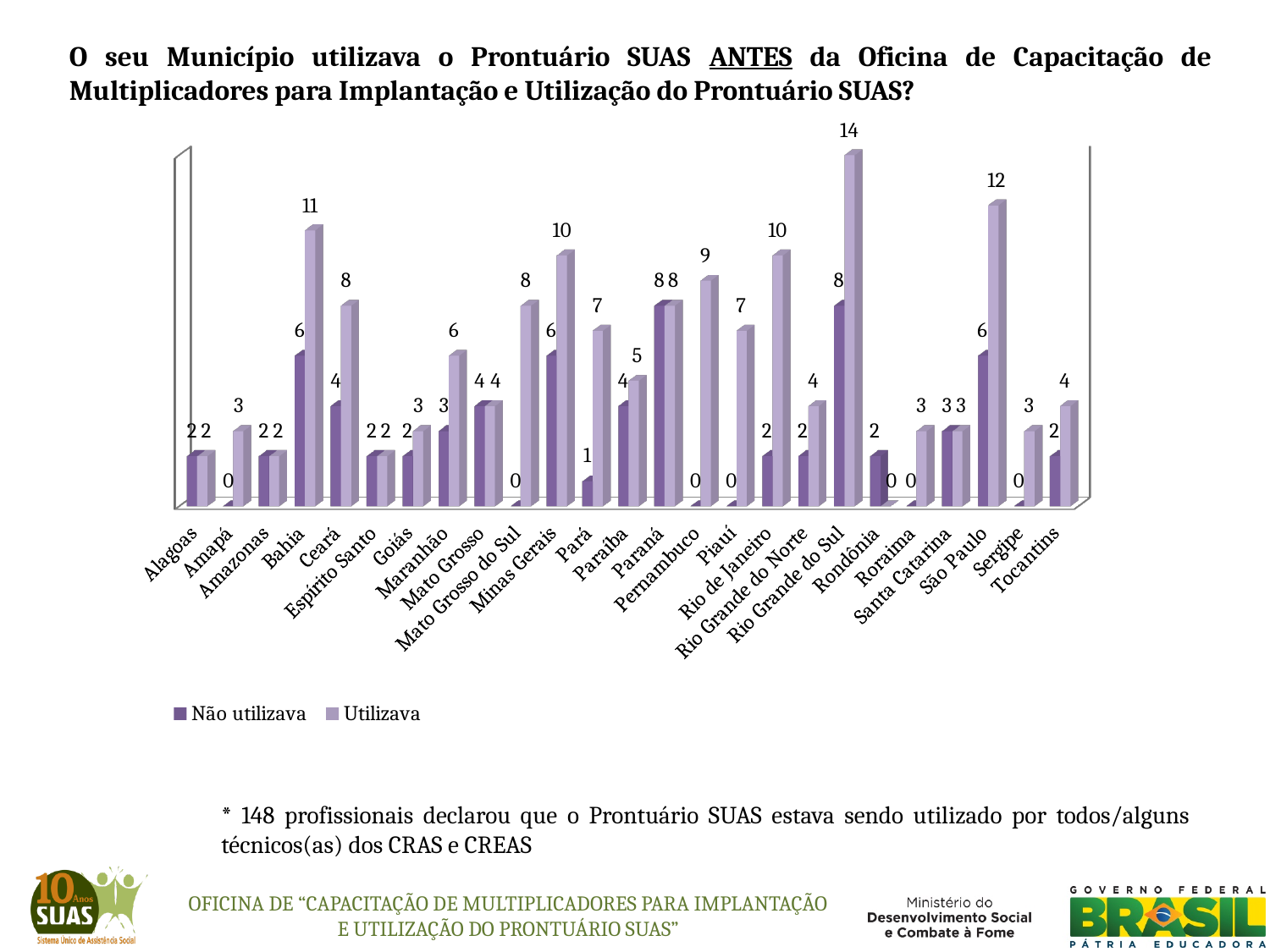
What is the 'Utilizava' value for Rondônia? 0 What type of chart is shown on the slide? bar chart What is the difference between the 'Utilizava' and 'Não utilizava' values for Rio de Janeiro? 8 What is the 'Utilizava' value for Rio Grande do Sul? 14 What are the two series named in the legend? Não utilizava and Utilizava What is the 'Não utilizava' value for Pernambuco? 0 How many states (categories) are shown on the x axis? 25 What is the 'Não utilizava' value for Bahia? 6 What is the 'Utilizava' value for São Paulo? 12 How many series does the legend list? 2 Which state has the highest 'Utilizava' value? Rio Grande do Sul Which is larger for Pará: the 'Não utilizava' value or the 'Utilizava' value? Utilizava